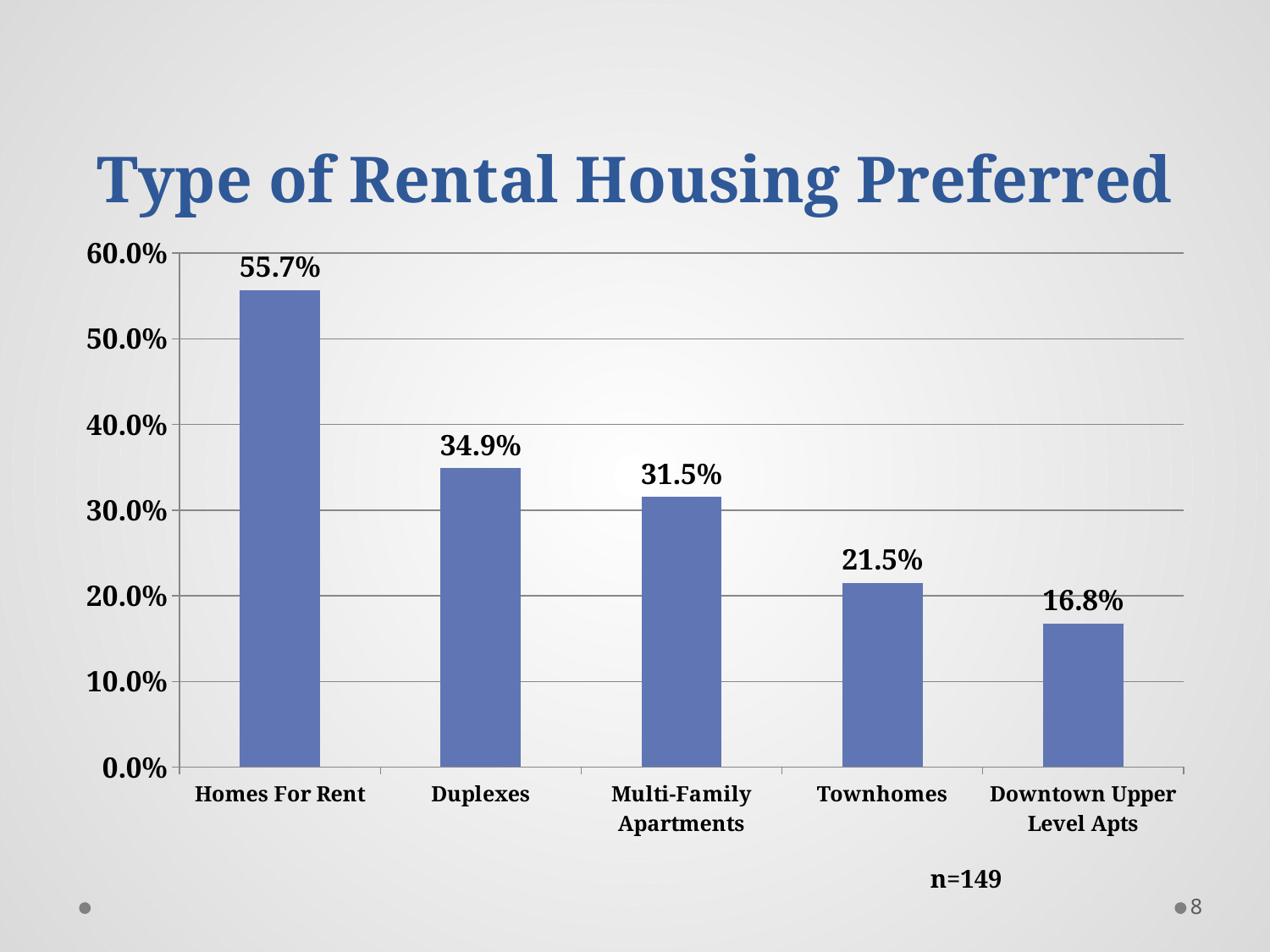
Which category has the lowest value? Downtown Upper Level Apts What is the difference between the values for Homes For Rent and Duplexes? 20.8% Which category has the highest value? Homes For Rent What is the value for Homes For Rent? 55.7% Which is larger, the value for Duplexes or the value for Townhomes? Duplexes What is the value for Downtown Upper Level Apts? 16.8% What is the value for Duplexes? 34.9% Is the value for Townhomes greater or less than 20.0%? greater What kind of chart is shown on the slide? Bar chart What is the value for Multi-Family Apartments? 31.5% How many categories are shown on the chart? 5 What is the difference between the values for Townhomes and Downtown Upper Level Apts? 4.7%